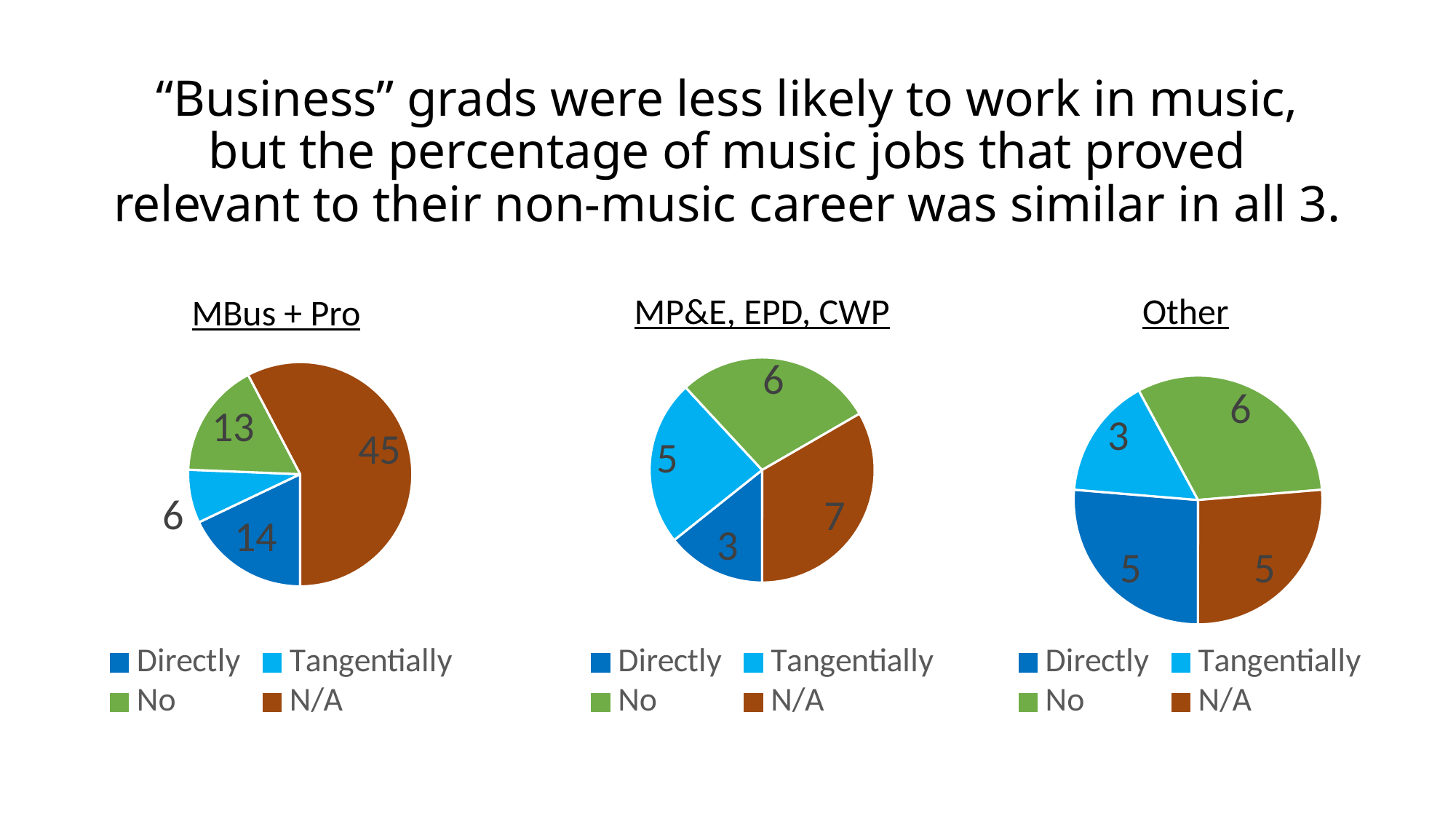
How many slices does the MBus + Pro chart have? 4 What kind of chart is the MP&E, EPD, CWP chart? Pie chart In the MP&E, EPD, CWP chart, which is larger, No or Tangentially? No In the MP&E, EPD, CWP chart, what is the value for Tangentially? 5 In the MBus + Pro chart, which category has the largest slice? N/A In the Other chart, which category has the smallest slice? Tangentially In the MBus + Pro chart, what is the difference between the N/A value and the Directly value? 31 In the Other chart, what is the total of all slices? 19 How many entries does the legend of the Other chart list? 4 In the MP&E, EPD, CWP chart, which category has the smallest slice? Directly In the MBus + Pro chart, what is the value for N/A? 45 In the Other chart, what is the value for No? 6